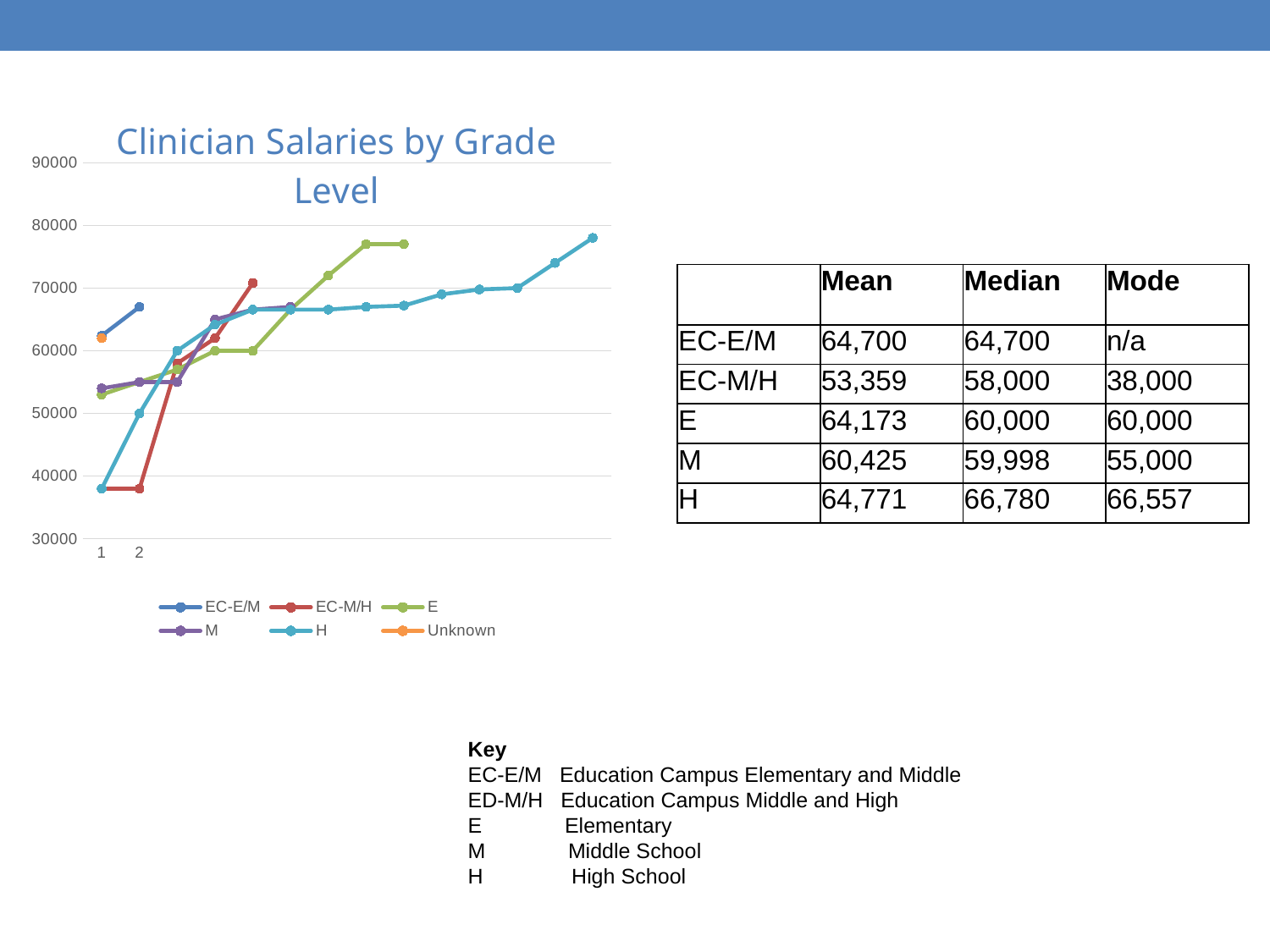
What kind of chart is shown on the slide? line chart Is the first value of the EC-M/H series greater or less than 40000? less Do the values of the H series rise or fall along the x axis? rise At x = 1, which is larger: the EC-E/M value or the H value? EC-E/M Is the last value of the E series greater or less than 70000? greater How many series does the legend of the chart list? 6 Is the last value of the H series greater or less than 70000? greater How many data points does the EC-E/M series have? 2 Which series in the legend is drawn in orange? Unknown What is the title of the chart? Clinician Salaries by Grade Level